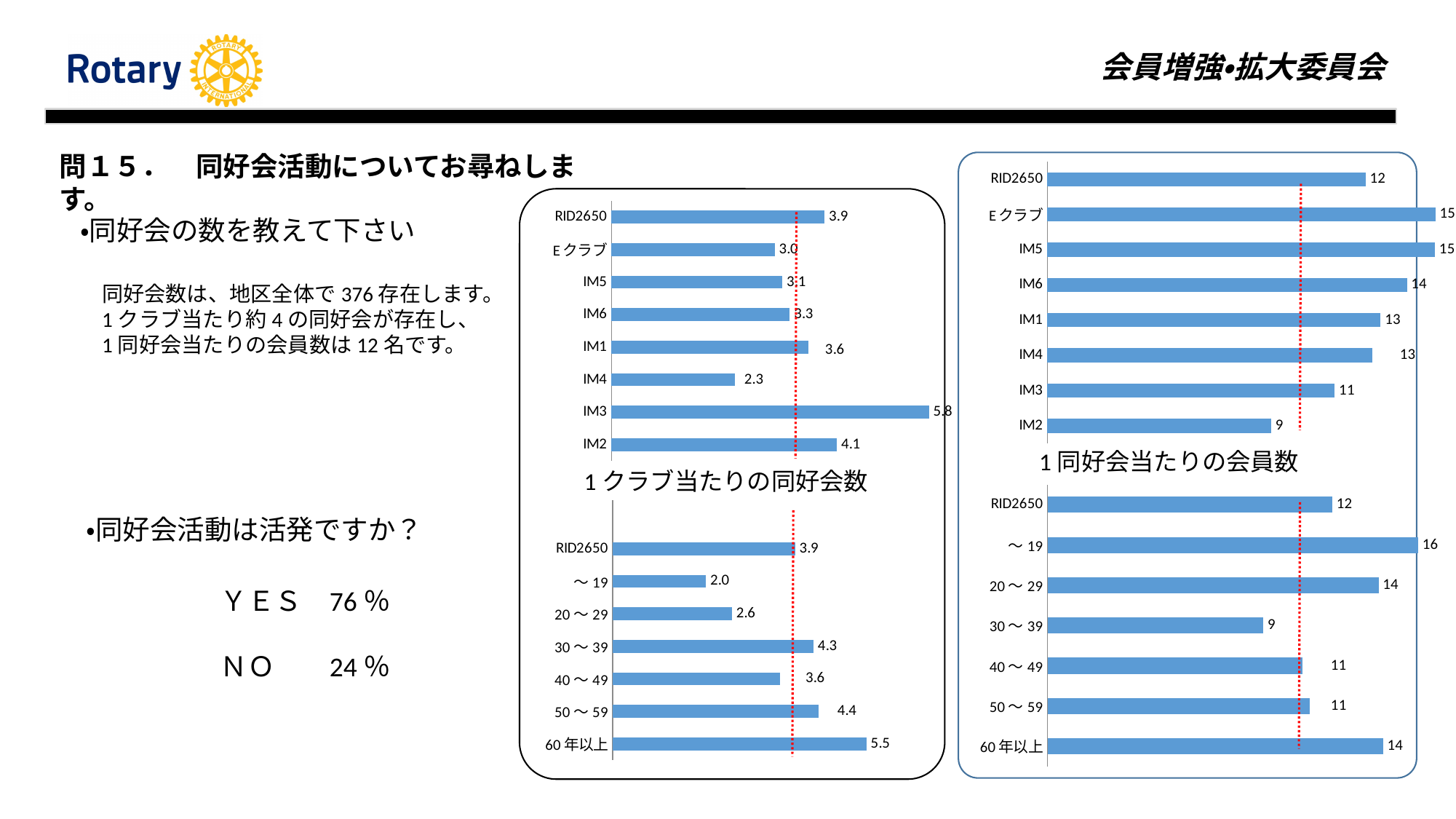
In the lower-left chart (1クラブ当たりの同好会数, by club age), which category has the lowest value? ～19 In the lower-right chart (1同好会当たりの会員数, by club age), which category has the highest value? ～19 In the lower-left chart (1クラブ当たりの同好会数, by club age), what is the value for 60年以上? 5.5 In the lower-right chart (1同好会当たりの会員数, by club age), what is the difference between ～19 and 30～39? 7 In the lower-left chart (1クラブ当たりの同好会数, by club age), which is larger, 30～39 or 40～49? 30～39 In the upper-left chart (1クラブ当たりの同好会数, by IM), what is the difference between IM3 and IM4? 3.5 In the upper-left chart (1クラブ当たりの同好会数, by IM), which category has the lowest value? IM4 In the upper-left chart (1クラブ当たりの同好会数, by IM), what is the value for IM3? 5.8 How many categories are shown in the lower-right chart (1同好会当たりの会員数, by club age)? 7 What type of chart is the upper-left chart (1クラブ当たりの同好会数)? Bar chart In the upper-right chart (1同好会当たりの会員数, by IM), what is the value for IM2? 9 In the upper-right chart (1同好会当たりの会員数, by IM), what is the value for IM6? 14